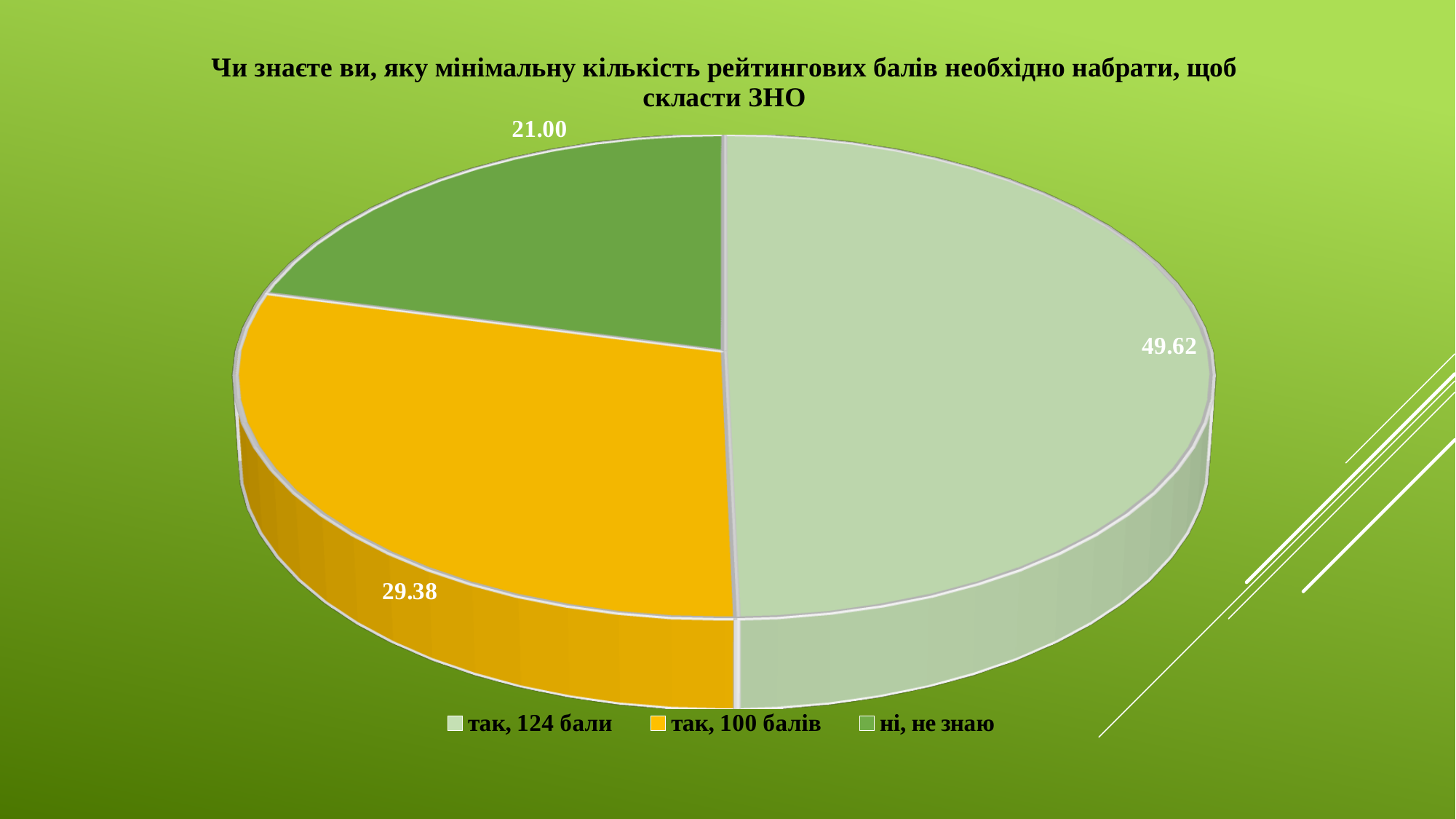
What kind of chart is shown on the slide? pie chart What value is shown for the slice "ні, не знаю"? 21.00 What colour is the slice for "так, 100 балів"? yellow Which is larger, the value for "так, 100 балів" or the value for "ні, не знаю"? так, 100 балів What value is shown for the slice "так, 100 балів"? 29.38 What is the total of all three slice values? 100.00 Which category has the largest slice of the pie? так, 124 бали What is the difference between the values for "так, 100 балів" and "ні, не знаю"? 8.38 What is the difference between the values for "так, 124 бали" and "так, 100 балів"? 20.24 Which category has the smallest slice of the pie? ні, не знаю What value is shown for the slice "так, 124 бали"? 49.62 How many slices does the pie chart have? 3